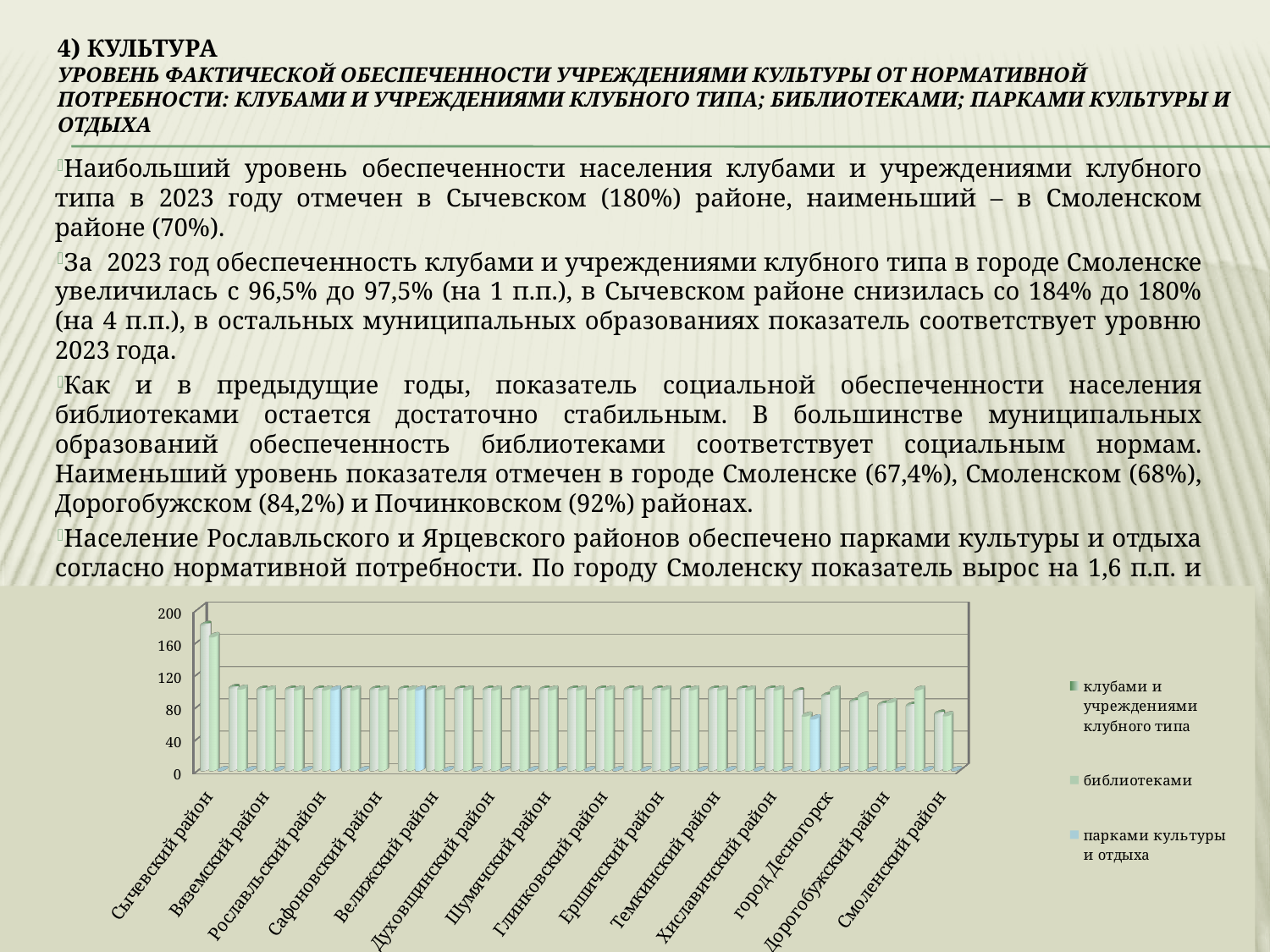
Is the value for Дорогобужский район in the series 'библиотеками' greater or less than 120? less Is the value for Сычевский район in the series 'клубами и учреждениями клубного типа' greater or less than 160? greater Is the value for Вяземский район in the series 'клубами и учреждениями клубного типа' greater or less than 80? greater What is the highest value shown on the chart's vertical axis? 200 What are the three series listed in the chart legend? клубами и учреждениями клубного типа; библиотеками; парками культуры и отдыха How many series does the chart legend list? 3 What kind of chart is shown on the slide? bar chart Which category has the highest value for the series 'клубами и учреждениями клубного типа'? Сычевский район Do the values for the series 'клубами и учреждениями клубного типа' generally rise or fall from left to right along the x axis? fall Which is larger for the series 'клубами и учреждениями клубного типа': Сычевский район or Вяземский район? Сычевский район